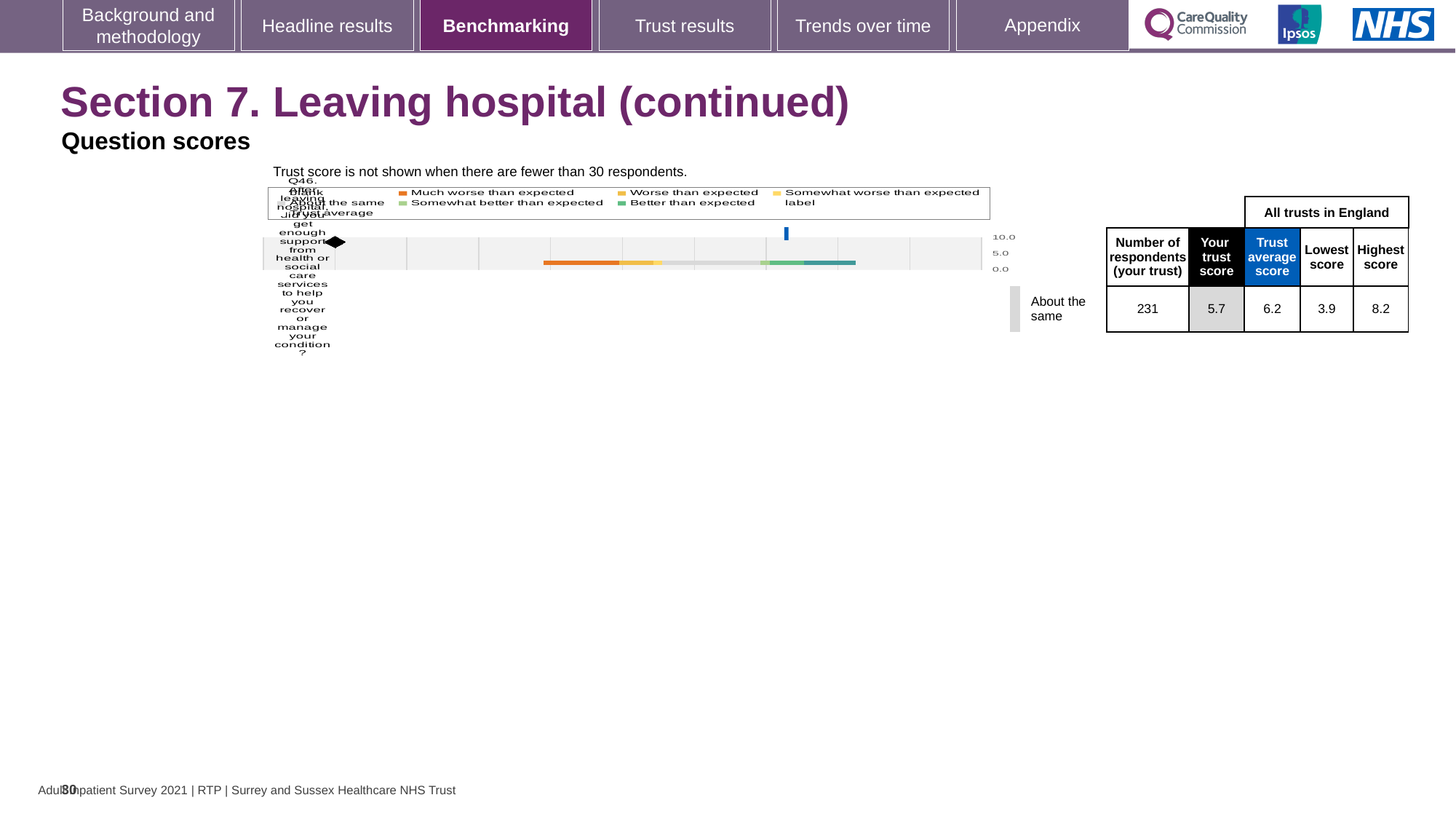
What is the lowest score among all trusts in England for Q46? 3.9 What is the trust score for Q46 shown in the table next to the chart? 5.7 Which is larger for Q46: the trust's own score or the trust average score? Trust average score What is the difference between the highest and lowest scores for Q46 across all trusts in England? 4.3 What kind of chart is used to show the Q46 benchmarking result? Bar chart What is the maximum value shown on the chart's axis? 10.0 Is the trust score for Q46 greater or less than 5.0 on the chart's axis? greater What benchmark category is the trust's Q46 score placed in? About the same What is the trust average score for Q46 across all trusts in England? 6.2 What is the highest score among all trusts in England for Q46? 8.2 How many respondents from the trust answered Q46? 231